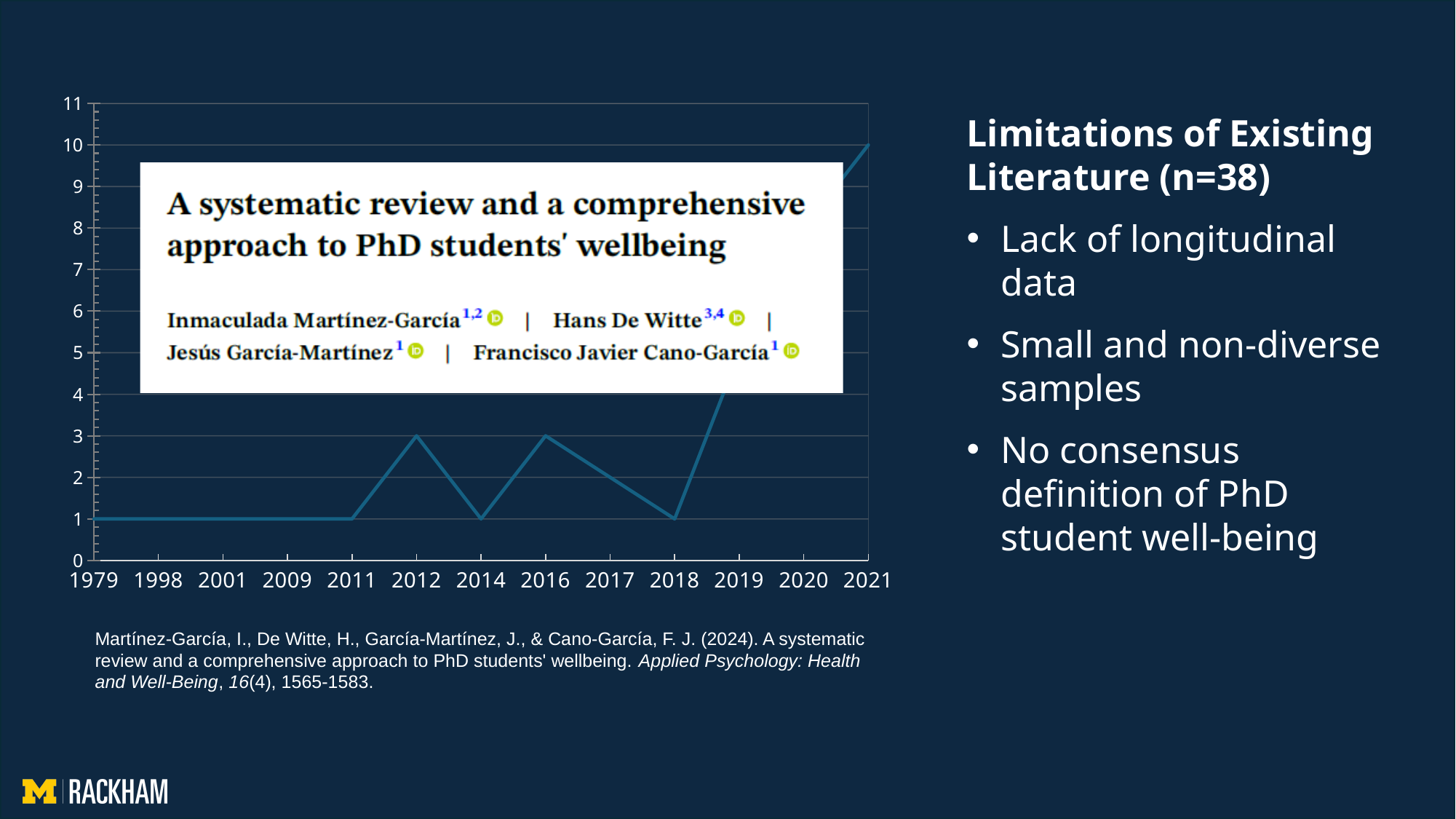
What is the value plotted for 2018? 1 What is the value plotted for 2012? 3 What is the value plotted for 2021? 10 Which year has the larger value, 2014 or 2016? 2016 Is the value for 2021 greater or less than 8? greater Does the line rise or fall between 2018 and 2021? rise What is the difference between the values for 2012 and 2017? 1 What is the value plotted for 1979? 1 What is the value plotted for 2017? 2 What kind of chart is shown on the left of the slide? line chart Which year has the larger value, 2012 or 2017? 2012 How many years are labelled on the x axis of the chart? 13